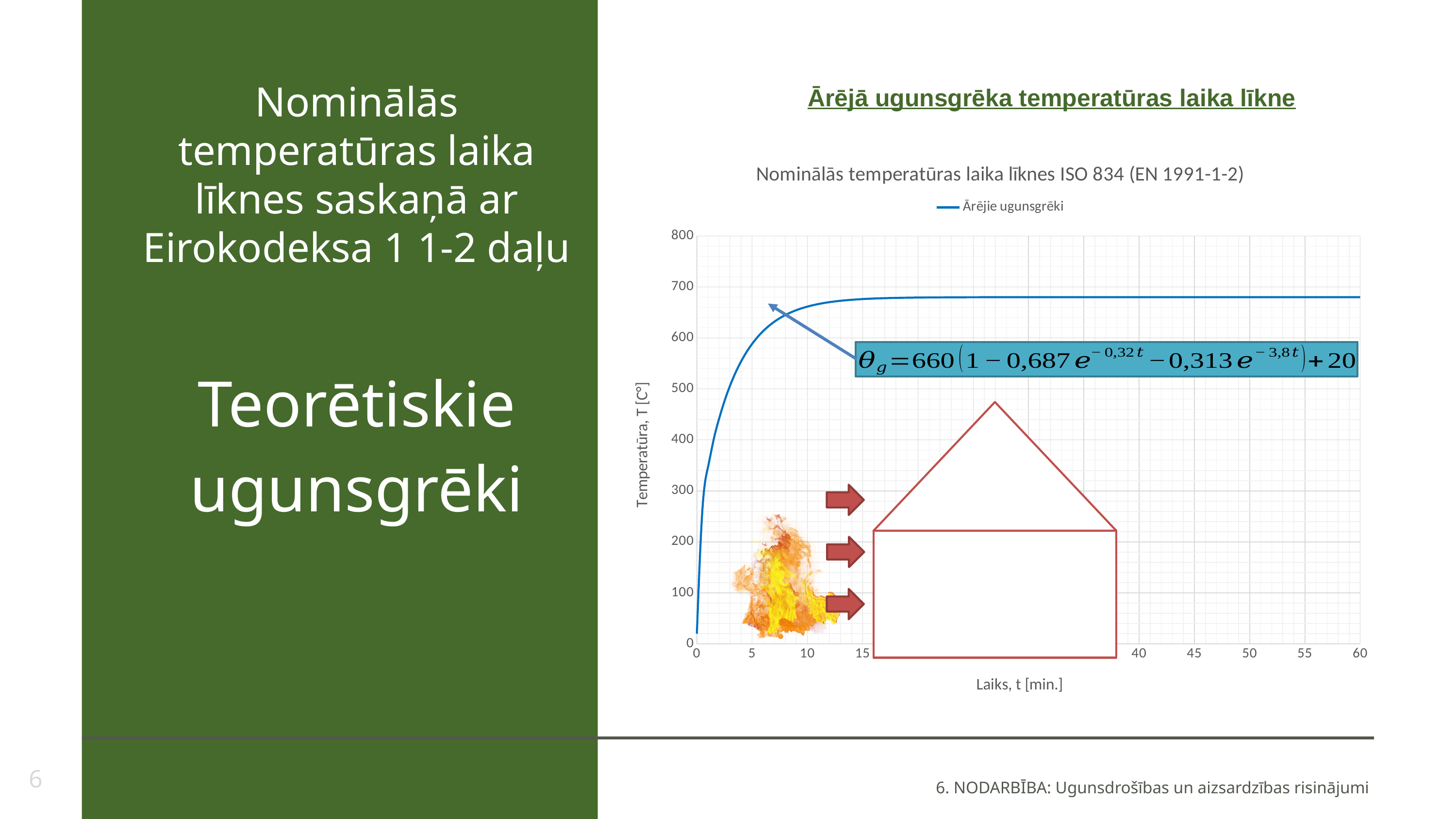
Is the value of the Ārējie ugunsgrēki curve at 10 minutes greater or less than 600? greater What is the name of the series shown in the chart legend? Ārējie ugunsgrēki Is the value of the Ārējie ugunsgrēki curve at 60 minutes greater or less than 700? less Does the temperature curve rise or fall as time increases along the x axis? rises, then levels off What is the highest tick value shown on the y axis of the chart? 800 What is the title of the chart? Nominālās temperatūras laika līknes ISO 834 (EN 1991-1-2) Is the value of the Ārējie ugunsgrēki curve at 60 minutes greater or less than 600? greater How many series does the chart legend list? 1 What is the highest tick value shown on the x axis of the chart? 60 What kind of chart is shown on the slide? line chart